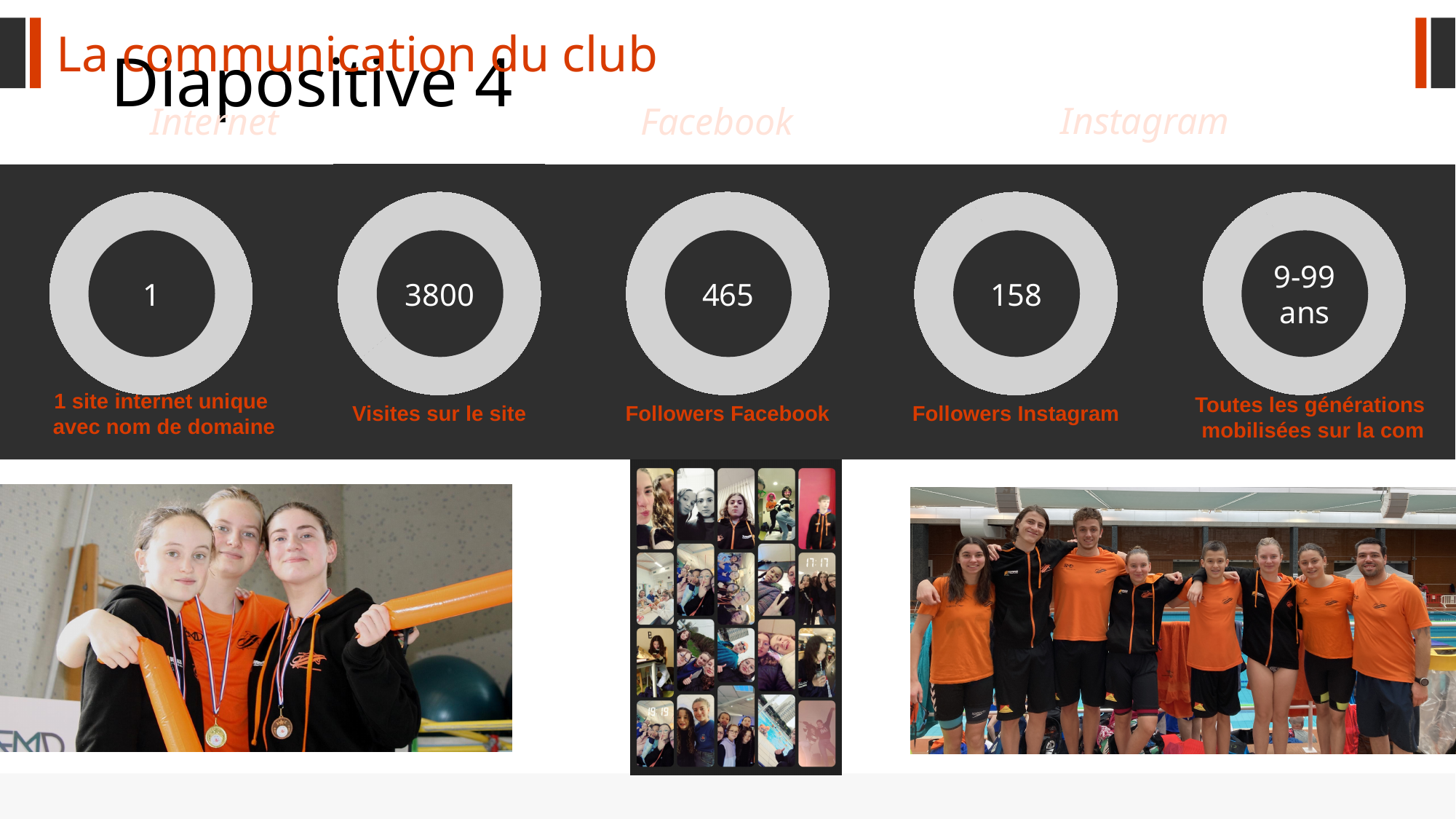
What is the difference between the Followers Facebook value and the Followers Instagram value? 307 What value is shown in the circle labelled 'Followers Instagram'? 158 What colour is the ring around each circular figure? Light grey Among the numeric circles (site internet, Visites sur le site, Followers Facebook, Followers Instagram), which has the highest value? Visites sur le site What is written in the centre of the circle labelled 'Toutes les générations mobilisées sur la com'? 9-99 ans What is the title of the slide shown in orange at the top? La communication du club How many circular figures are shown in the dark band across the slide? 5 What value is shown in the circle labelled '1 site internet unique avec nom de domaine'? 1 What value is shown in the circle labelled 'Followers Facebook'? 465 What value is shown in the circle labelled 'Visites sur le site'? 3800 Among the numeric circles (site internet, Visites sur le site, Followers Facebook, Followers Instagram), which has the lowest value? 1 site internet unique avec nom de domaine Which is larger, the number of Followers Facebook or the number of Followers Instagram? Followers Facebook